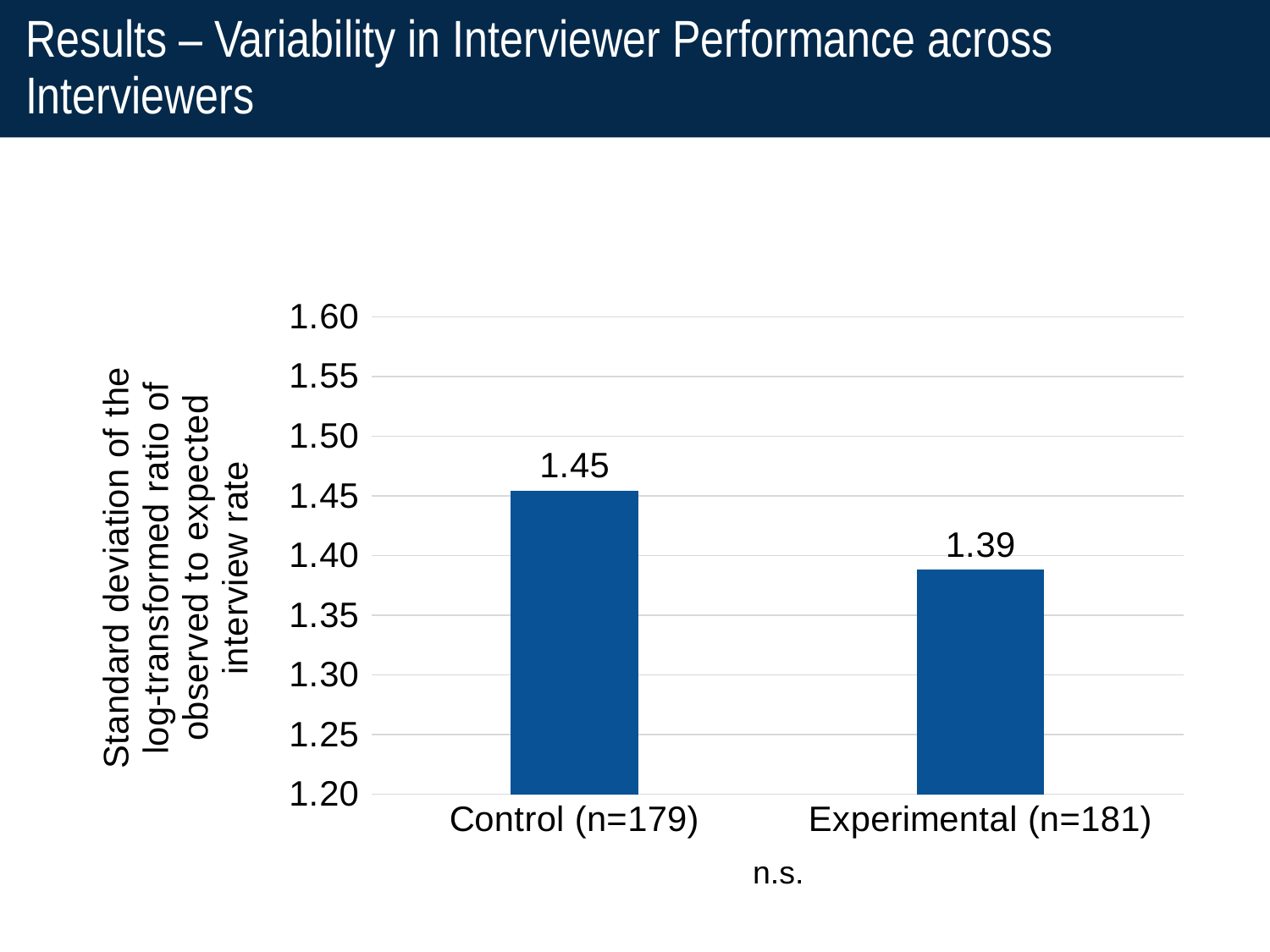
What is the value for Control (n=179)? 1.45 What is the difference between the values for Control (n=179) and Experimental (n=181)? 0.06 What is the label of the y axis? Standard deviation of the log-transformed ratio of observed to expected interview rate What kind of chart is shown on the slide? bar chart Which category has the lowest value? Experimental (n=181) Which category has the highest value? Control (n=179) What is the value for Experimental (n=181)? 1.39 Is the value for Control (n=179) greater or less than 1.40? greater How many categories are shown on the x axis? 2 Which is larger, the value for Control (n=179) or for Experimental (n=181)? Control (n=179) Is the value for Experimental (n=181) greater or less than 1.40? less Do the values rise or fall from Control (n=179) to Experimental (n=181)? fall